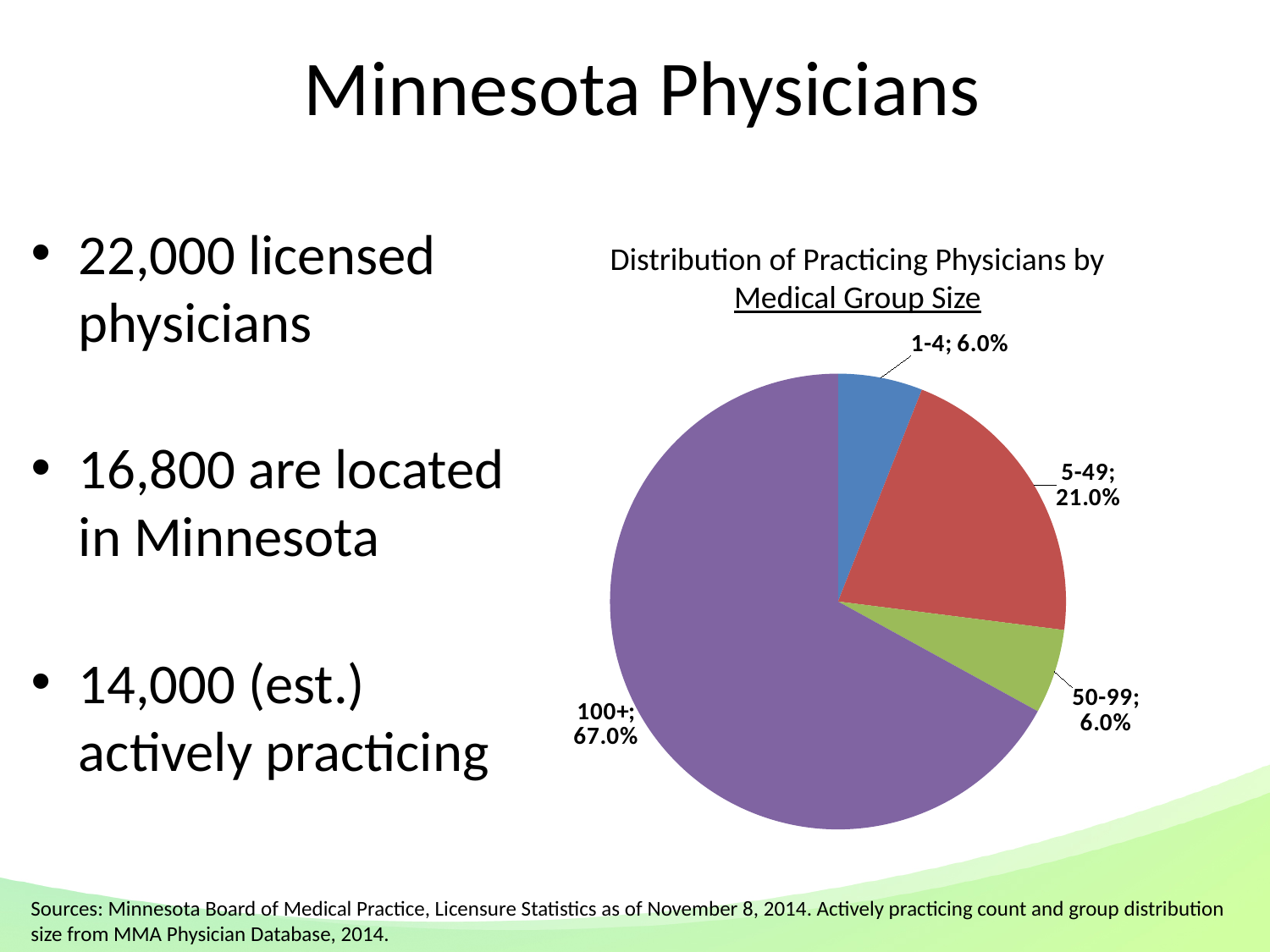
What share of practicing physicians are in medical groups of size 5-49? 21.0% How many slices does the pie chart have? 4 What share of practicing physicians are in medical groups of size 1-4? 6.0% Which is larger, the share for 5-49 or the share for 50-99? 5-49 What is the combined share of the 1-4 and 50-99 groups? 12.0% What share of practicing physicians are in medical groups of size 50-99? 6.0% What is the title of the chart? Distribution of Practicing Physicians by Medical Group Size What share of practicing physicians are in medical groups of size 100+? 67.0% What is the difference in percentage points between the 100+ share and the 5-49 share? 46.0 What colour is the slice for the 100+ medical group size? purple Which medical group size has the largest share of practicing physicians? 100+ What type of chart is shown on the slide? pie chart